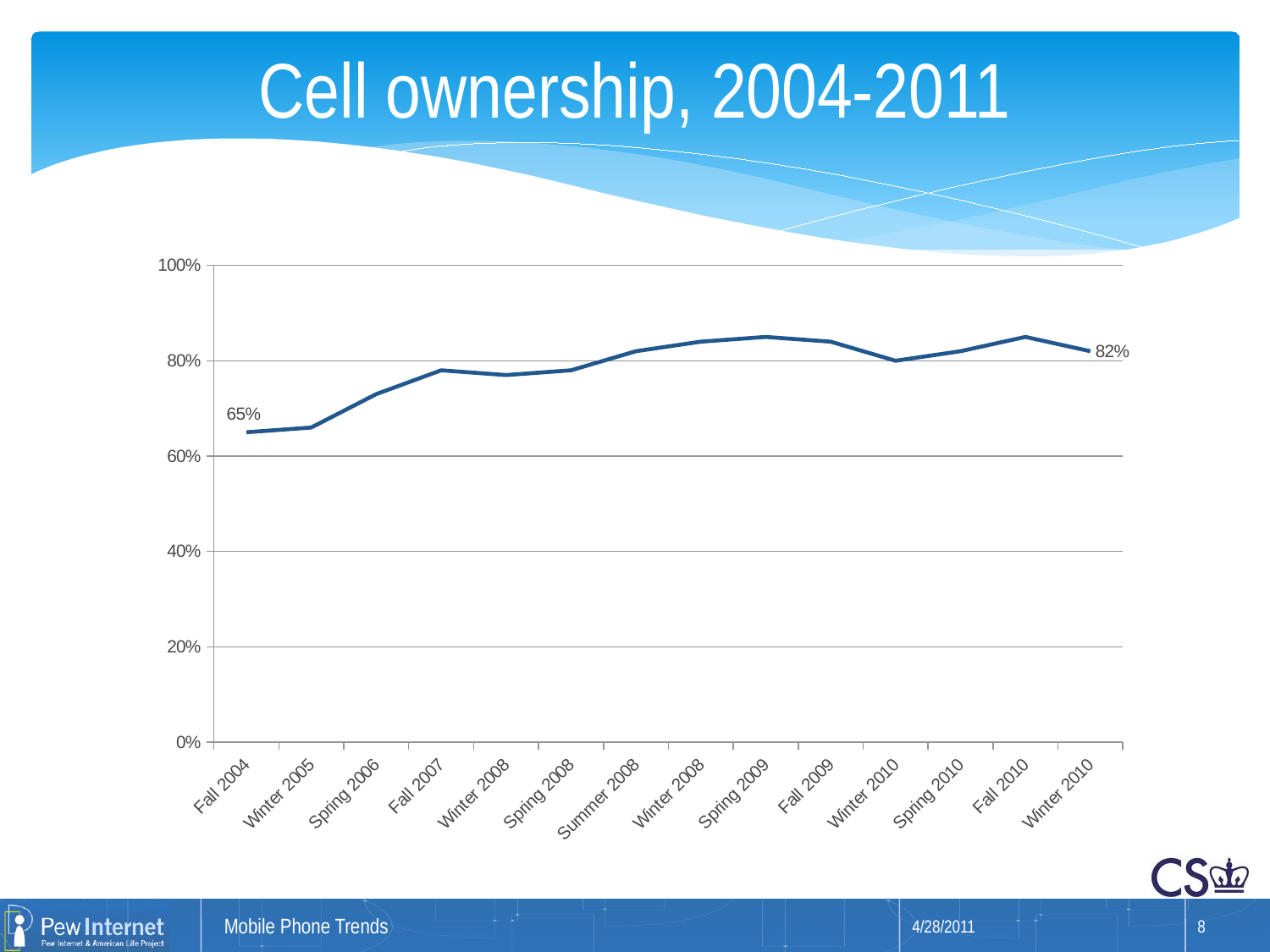
How many data points are plotted along the x axis? 14 Is the value for Spring 2006 greater or less than 80%? less Overall, do the values rise or fall from Fall 2004 to Winter 2010? rise What kind of chart is shown on the slide? line chart What is the title of the chart? Cell ownership, 2004-2011 Is the value for Fall 2007 greater or less than 80%? less What is the cell ownership value for Fall 2004? 65% Which point has the lowest cell ownership value? Fall 2004 By how many percentage points did cell ownership change from Fall 2004 (65%) to the final Winter 2010 point (82%)? 17% Is the value for Spring 2009 greater or less than 80%? greater Which is larger, the value for Fall 2004 or the value for the final Winter 2010 point? Winter 2010 What is the cell ownership value at the last point, Winter 2010? 82%